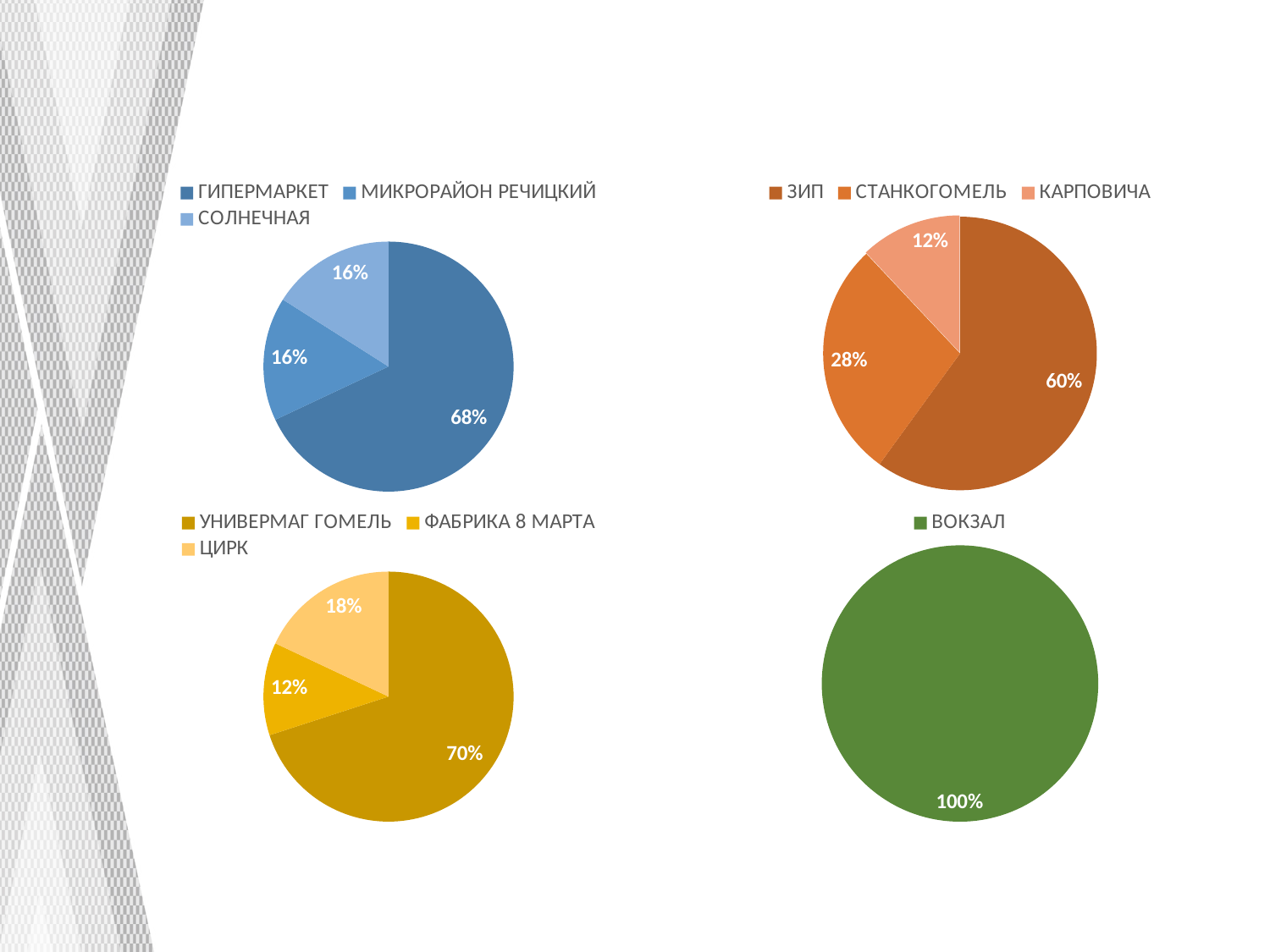
In the top-left pie chart, which category has the largest slice? ГИПЕРМАРКЕТ In the bottom-right pie chart, what share does ВОКЗАЛ have? 100% In the top-left pie chart, what share does ГИПЕРМАРКЕТ have? 68% What type of chart is the top-right chart? Pie chart In the top-right pie chart, what share does СТАНКОГОМЕЛЬ have? 28% In the bottom-left pie chart, what is the value for УНИВЕРМАГ ГОМЕЛЬ? 70% How many categories does the legend of the bottom-left pie chart list? 3 In the top-right pie chart, what is the difference between ЗИП and СТАНКОГОМЕЛЬ? 32% In the top-left pie chart, what is the value for СОЛНЕЧНАЯ? 16% In the bottom-left pie chart, which is larger, ФАБРИКА 8 МАРТА or ЦИРК? ЦИРК In the top-right pie chart, which category has the smallest slice? КАРПОВИЧА